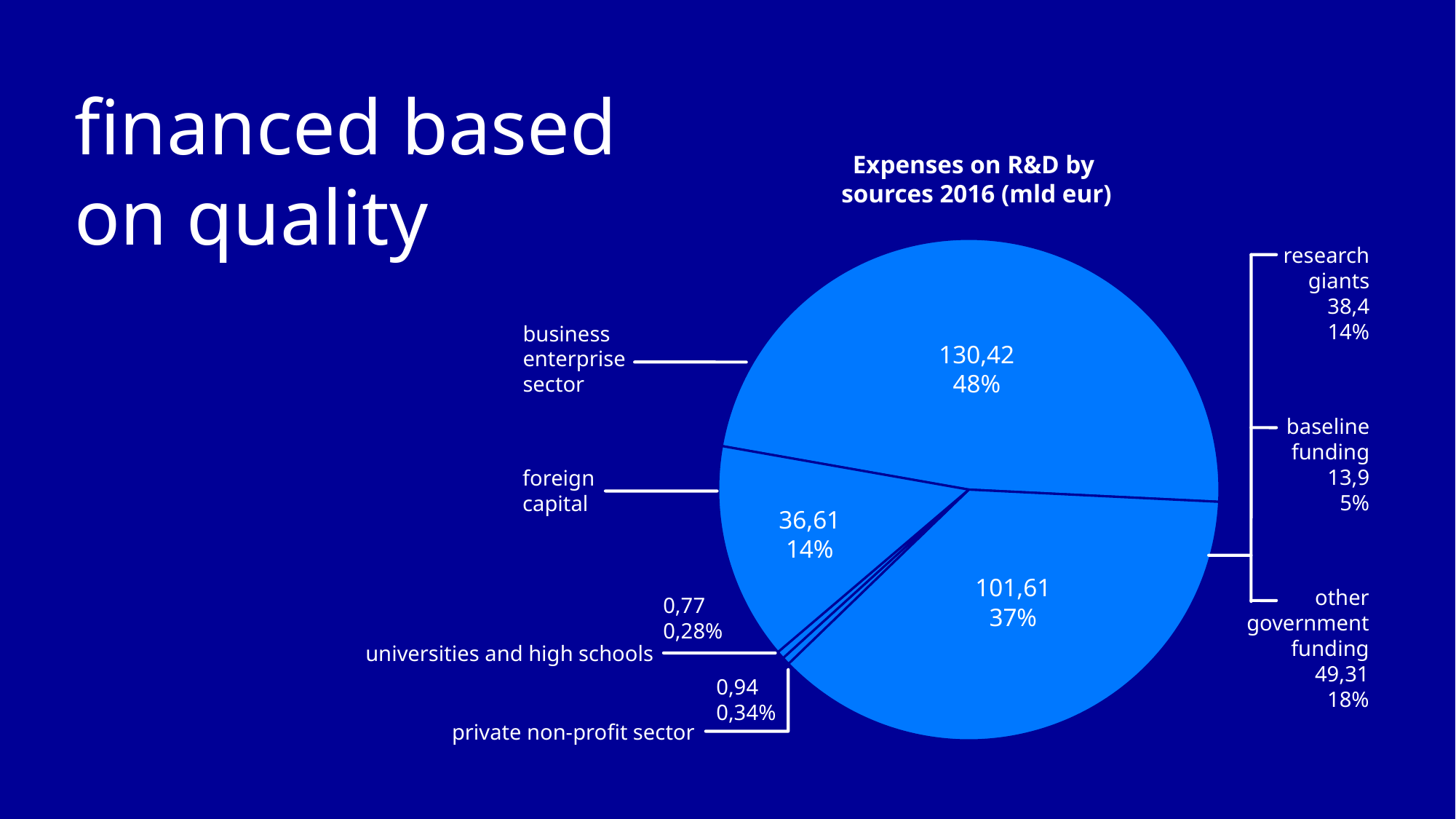
Which source has the smallest slice of the pie? universities and high schools What is the difference between other government funding (49,31) and baseline funding (13,9)? 35,41 What is the value for research giants? 38,4 What is the value for foreign capital? 36,61 What is the difference between the business enterprise sector value (130,42) and the 101,61 slice? 28,81 Which is larger, foreign capital or the private non-profit sector? foreign capital What is the title of the chart? Expenses on R&D by sources 2016 (mld eur) What kind of chart is shown on the slide? pie chart What is the value for the business enterprise sector in the pie chart? 130,42 What share is shown for other government funding? 18% Which source has the largest slice of the pie? business enterprise sector What share of the pie does the business enterprise sector hold? 48%